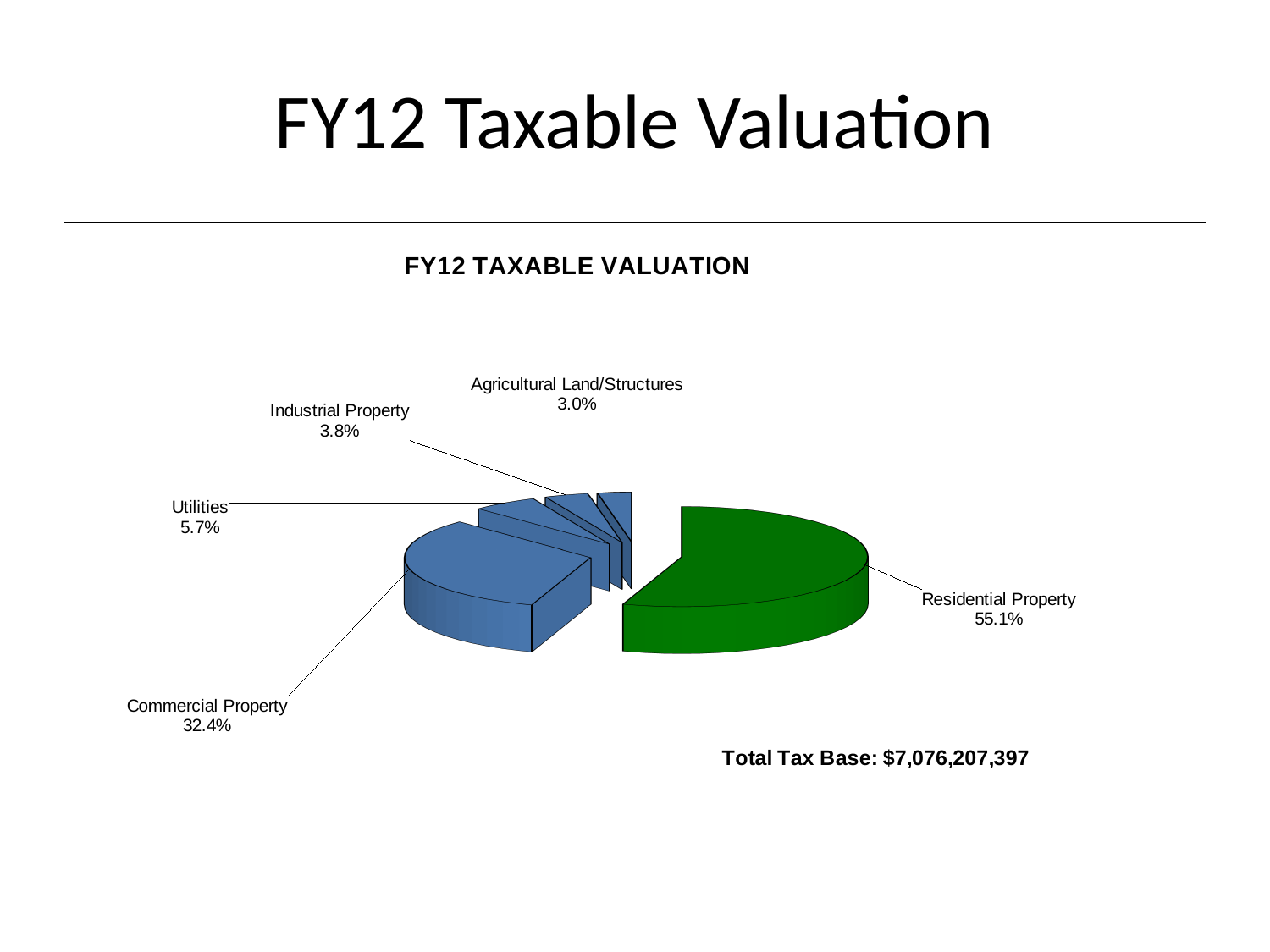
Which category has the smallest share of the FY12 taxable valuation? Agricultural Land/Structures What share of the FY12 taxable valuation is Agricultural Land/Structures? 3.0% How many categories are shown in the pie chart? 5 What share of the FY12 taxable valuation is Residential Property? 55.1% Which has a larger share, Utilities or Industrial Property? Utilities What share of the FY12 taxable valuation is Industrial Property? 3.8% What is the difference in percentage points between the Residential Property and Commercial Property shares? 22.7 What share of the FY12 taxable valuation is Commercial Property? 32.4% What kind of chart is shown on the slide? Pie chart What share of the FY12 taxable valuation is Utilities? 5.7% What is the total tax base stated on the chart? $7,076,207,397 Which category has the largest share of the FY12 taxable valuation? Residential Property